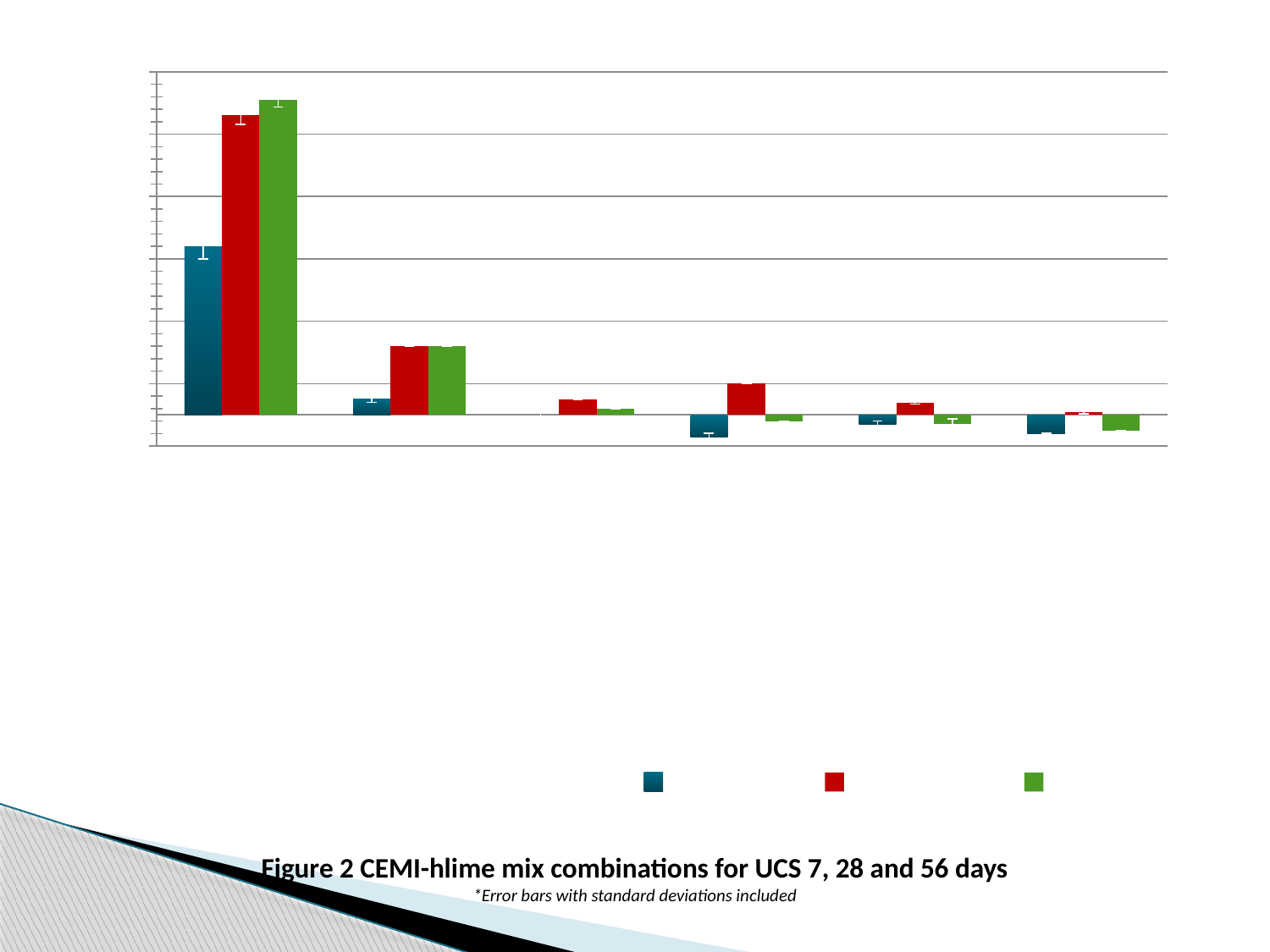
What is the figure caption shown below the chart? Figure 2 CEMI-hlime mix combinations for UCS 7, 28 and 56 days In the second group from the left, is the red bar taller or shorter than the blue bar? taller In the leftmost group of bars, which colour bar is the tallest? green Do the bar heights generally rise or fall moving from left to right along the x axis? fall In the leftmost group of bars, which colour bar is the shortest? blue What does the note under the figure caption say the error bars represent? standard deviations Which group of bars, by position from the left, has the tallest bars? the first (leftmost) group What kind of chart is shown on the slide? bar chart How many groups of bars are plotted along the x axis? 6 How many series does the legend list? 3